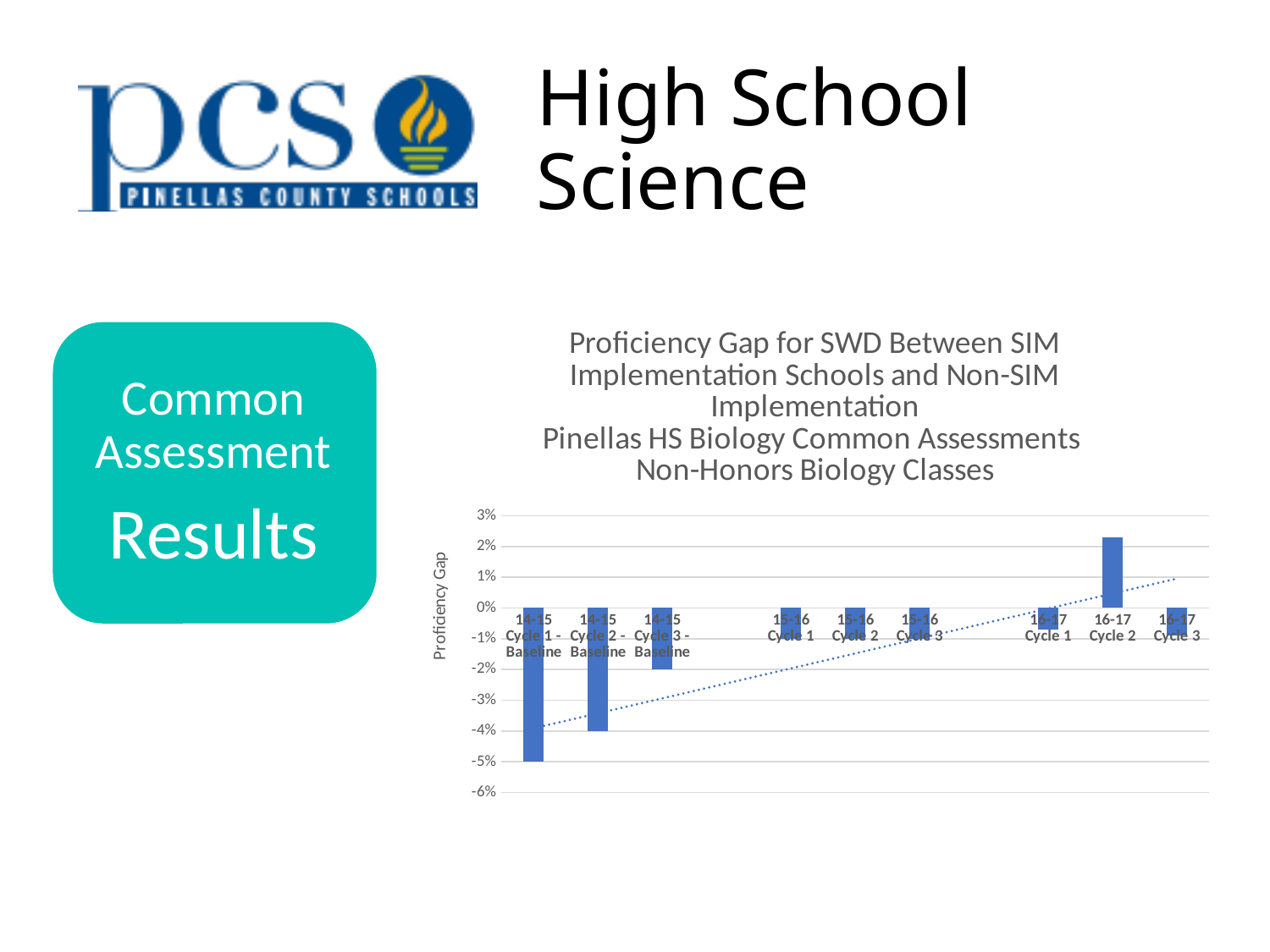
Does the dotted trend line in the chart rise or fall from left to right? Rises How many categories are plotted along the x axis of the chart? 9 Which is larger, the value for 16-17 Cycle 2 or the value for 16-17 Cycle 3? 16-17 Cycle 2 What is the title of the vertical axis of the chart? Proficiency Gap What kind of chart is shown on the slide? Bar chart Which category has the highest proficiency gap value in the chart? 16-17 Cycle 2 Which category has the lowest proficiency gap value in the chart? 14-15 Cycle 1 - Baseline Is the value for 14-15 Cycle 1 - Baseline greater or less than -4%? less Which is larger, the value for 14-15 Cycle 1 - Baseline or the value for 14-15 Cycle 2 - Baseline? 14-15 Cycle 2 - Baseline Is the value for 15-16 Cycle 1 greater or less than -2%? greater How many bars in the chart are above 0%? 1 Is the value for 16-17 Cycle 2 greater or less than 2%? greater